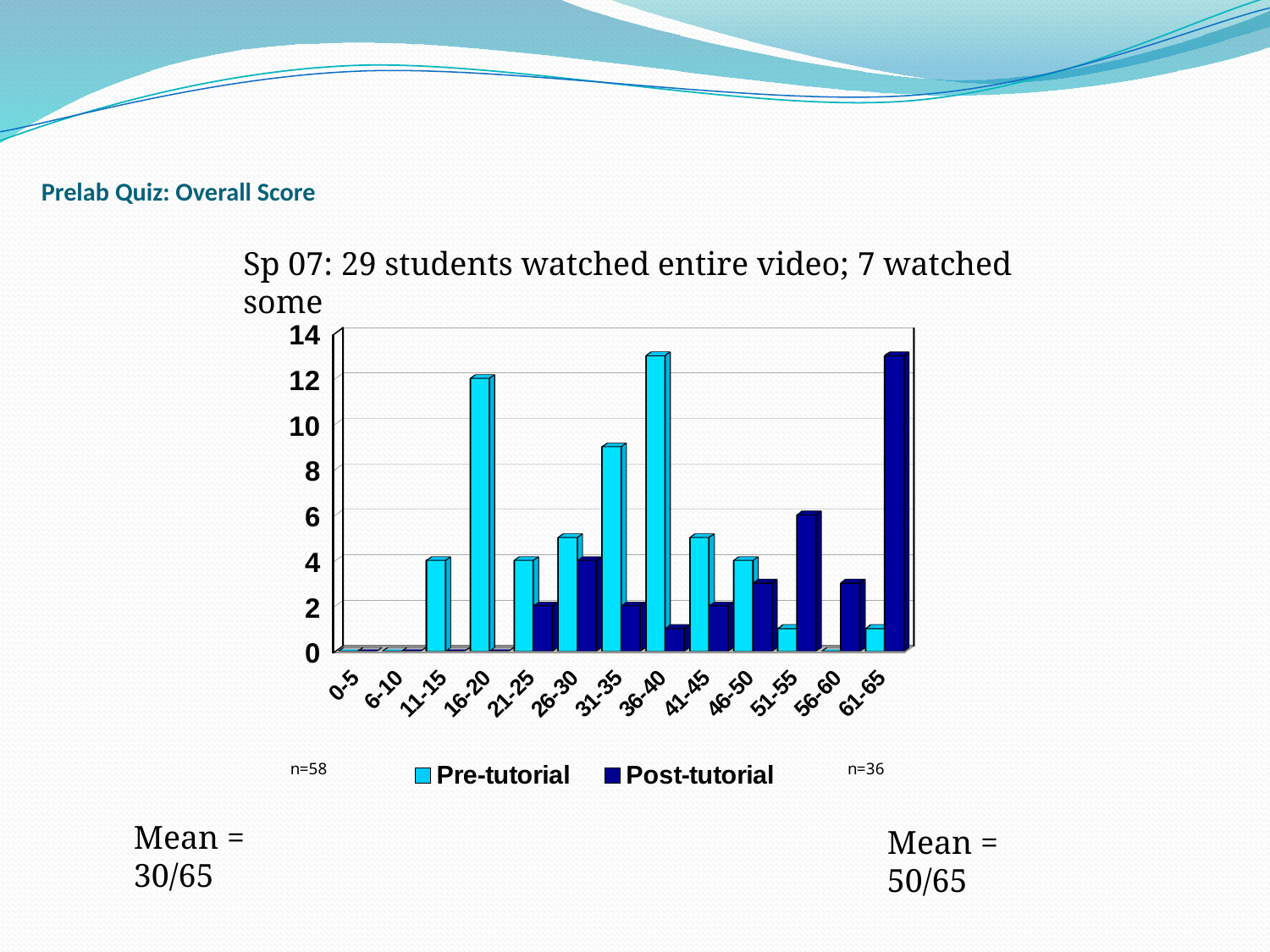
Is the Pre-tutorial value for 16-20 greater or less than 10? greater What kind of chart is shown on the slide? bar chart Is the Post-tutorial value for 51-55 greater or less than 4? greater How many score ranges are shown along the x axis? 13 For the 61-65 score range, which series has the larger value, Pre-tutorial or Post-tutorial? Post-tutorial Which score range has the highest Post-tutorial bar? 61-65 How many series does the legend list? 2 What are the two series named in the legend? Pre-tutorial and Post-tutorial Which score range has the highest Pre-tutorial bar? 36-40 For the 16-20 score range, which series has the larger value, Pre-tutorial or Post-tutorial? Pre-tutorial Is the Post-tutorial value for 36-40 greater or less than 2? less